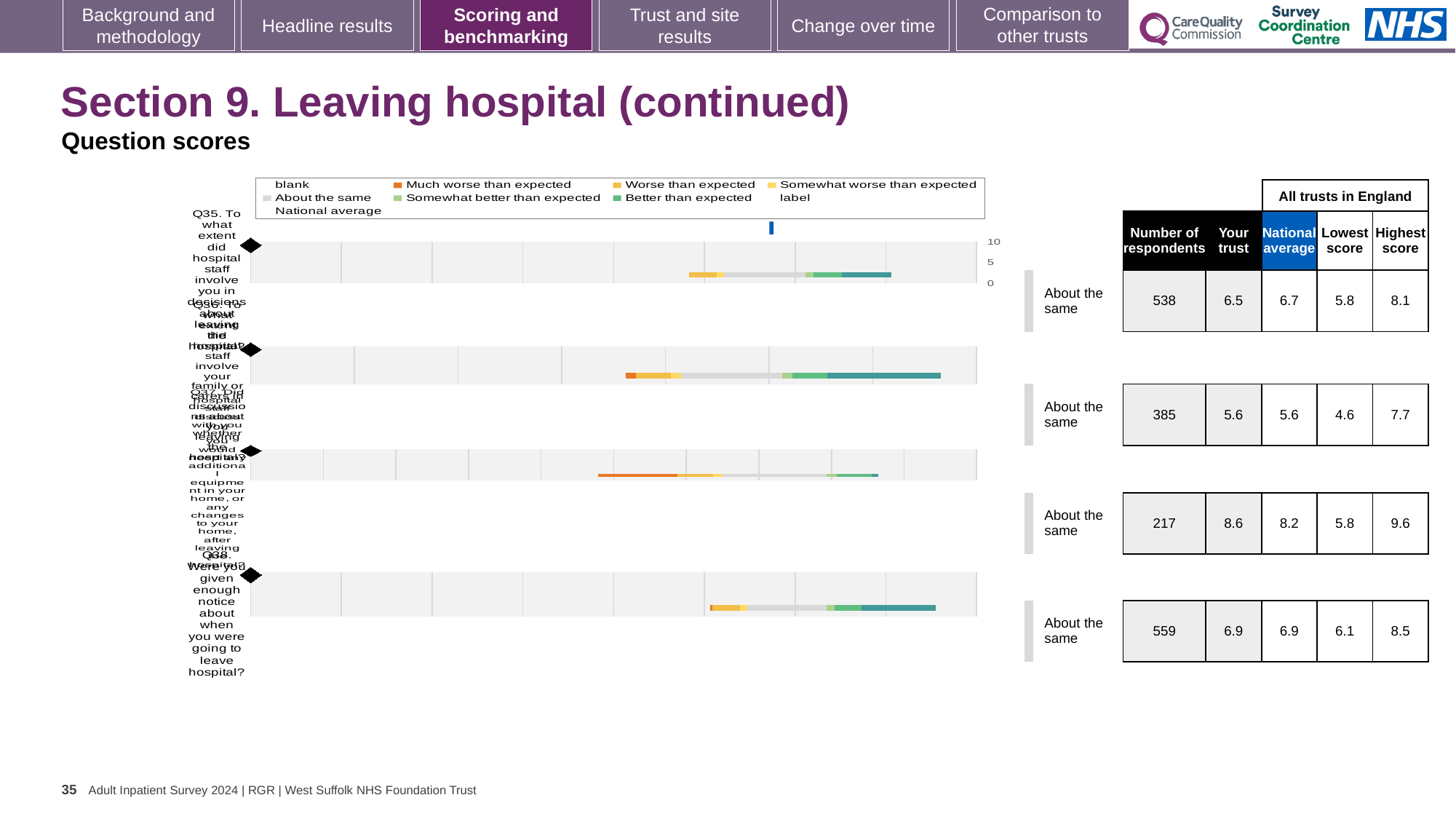
What is the lowest score across all trusts in England for Q38? 6.1 Which row has the highest 'Your trust' score? the third row (8.6) For Q35, which is larger: the 'Your trust' score or the national average? national average What benchmark category is shown next to every row of the chart? About the same What is the difference between the highest score and the lowest score for Q38? 2.4 How many entries does the chart legend list? 9 What is the 'Your trust' score for Q38 (Were you given enough notice about when you were going to leave hospital?)? 6.9 What is the title of the slide containing the chart? Section 9. Leaving hospital (continued) What kind of chart is shown on the slide? bar chart How many questions (rows) are plotted in the chart? 4 How many respondents are shown for Q35 (To what extent did hospital staff involve you in decisions about leaving the hospital?)? 538 What is the national average score for Q35? 6.7